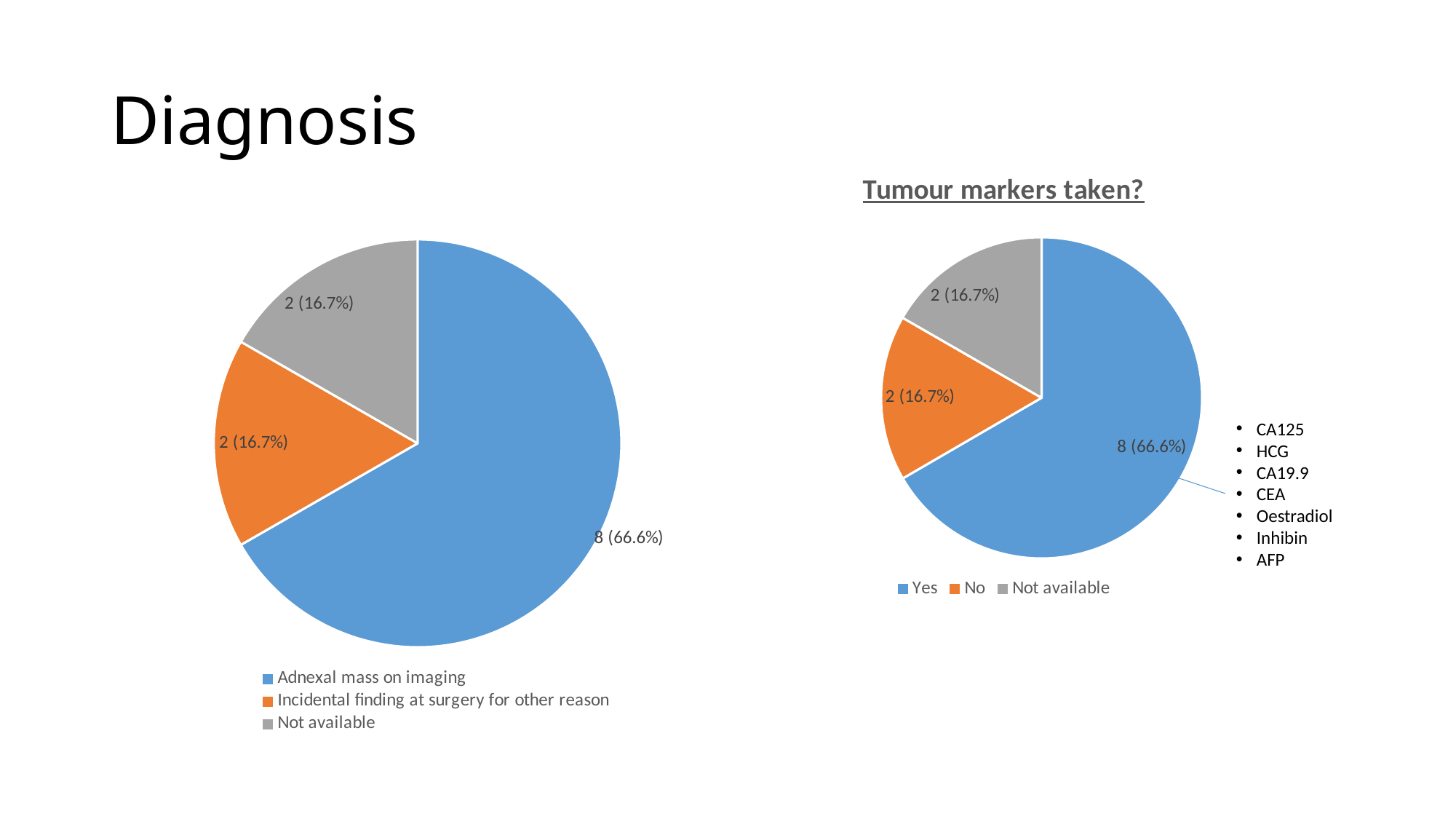
In the left pie chart, what is the data label for Incidental finding at surgery for other reason? 2 (16.7%) In the left pie chart, which category has the largest slice? Adnexal mass on imaging In the 'Tumour markers taken?' chart, what is the data label for No? 2 (16.7%) In the left pie chart, what is the difference between the count for Adnexal mass on imaging and the count for Not available? 6 What kind of chart is the 'Tumour markers taken?' chart? Pie chart In the 'Tumour markers taken?' chart, how many entries does the legend list? 3 In the left pie chart, how many slices does the pie have? 3 In the 'Tumour markers taken?' chart, what is the data label for Yes? 8 (66.6%) In the 'Tumour markers taken?' chart, which is larger, the slice for Yes or the slice for No? Yes In the 'Tumour markers taken?' chart, which category has the largest slice? Yes In the left pie chart, what share of the pie does Not available represent? 16.7% In the left pie chart, what is the data label for Adnexal mass on imaging? 8 (66.6%)